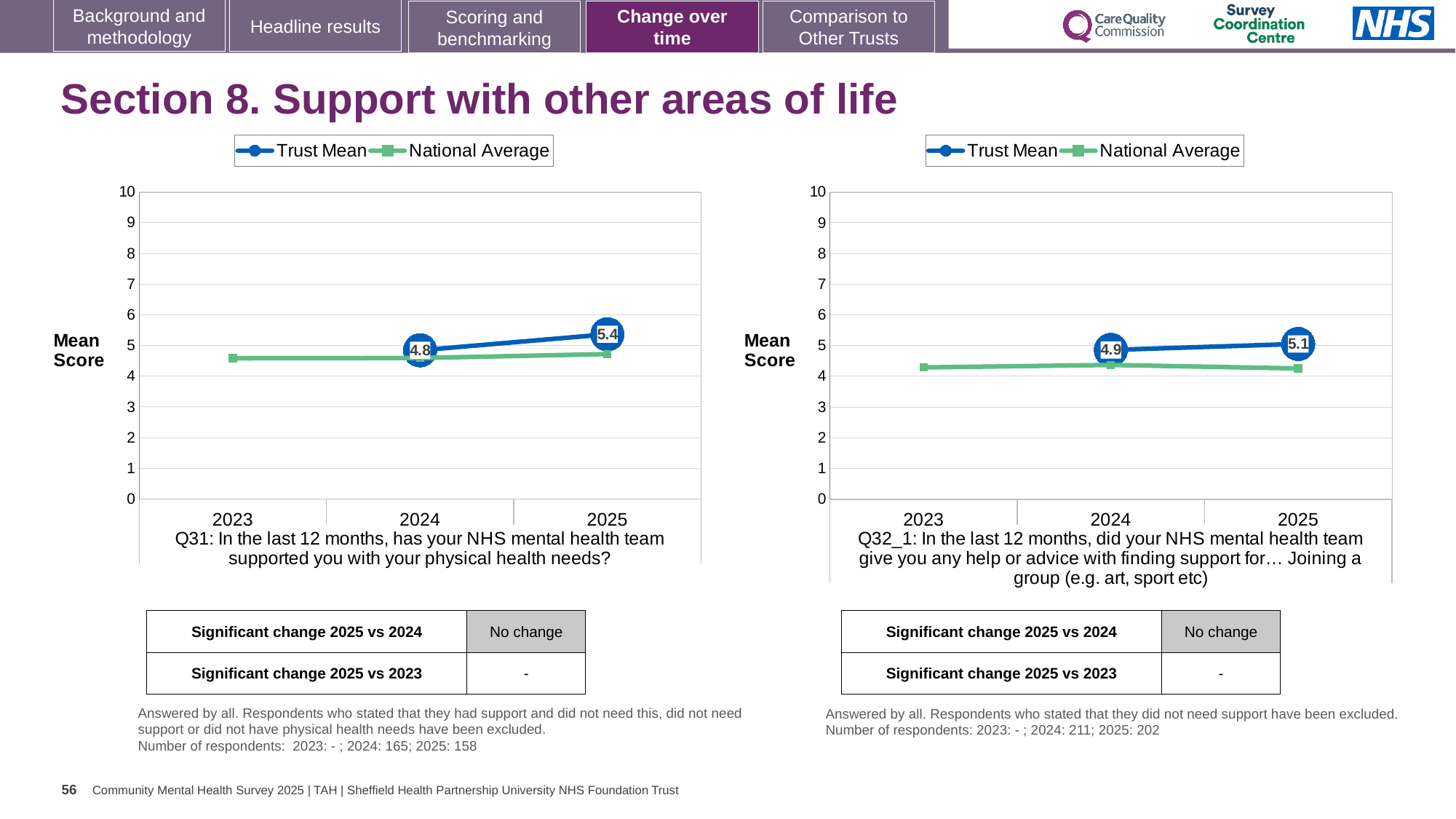
What kind of chart is the left chart (Q31)? Line chart In the right chart (Q32_1), what is the Trust Mean for 2024? 4.9 In the left chart (Q31), is the National Average for 2023 greater or less than 4? greater In the right chart (Q32_1), does the Trust Mean rise or fall from 2024 to 2025? Rise In the left chart (Q31), by how much did the Trust Mean change from 2024 to 2025? 0.6 In the left chart (Q31), is the Trust Mean higher in 2024 or 2025? 2025 In the left chart (Q31), what is the Trust Mean for 2025? 5.4 In the right chart (Q32_1), is the National Average for 2025 greater or less than 5? less In the right chart (Q32_1), what is the difference between the Trust Mean in 2025 and in 2024? 0.2 How many series does the legend of the right chart (Q32_1) list? 2 In the right chart (Q32_1), what is the Trust Mean for 2025? 5.1 In the left chart (Q31), what is the Trust Mean for 2024? 4.8